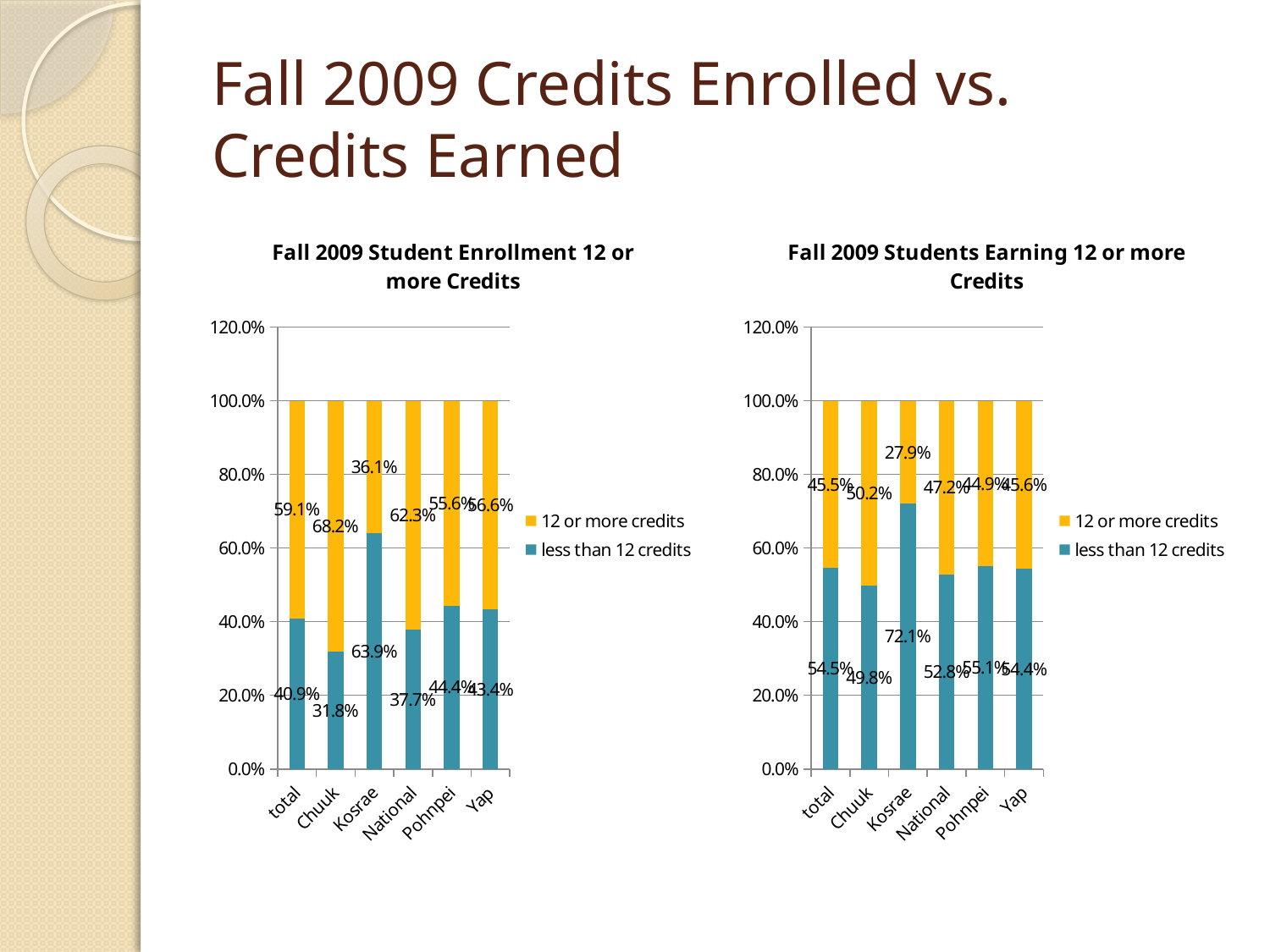
In the 'Fall 2009 Students Earning 12 or more Credits' chart, which category has the lowest '12 or more credits' value? Kosrae In the 'Fall 2009 Students Earning 12 or more Credits' chart, what is the value for Kosrae in the '12 or more credits' series? 27.9% In the 'Fall 2009 Students Earning 12 or more Credits' chart, what is the value for total in the 'less than 12 credits' series? 54.5% In the 'Fall 2009 Student Enrollment 12 or more Credits' chart, what is the difference between the 'less than 12 credits' values for Kosrae and Chuuk? 32.1% In the 'Fall 2009 Student Enrollment 12 or more Credits' chart, what is the value for Kosrae in the 'less than 12 credits' series? 63.9% In the 'Fall 2009 Student Enrollment 12 or more Credits' chart, what is the value for Chuuk in the '12 or more credits' series? 68.2% How many series does the legend of the 'Fall 2009 Student Enrollment 12 or more Credits' chart list? 2 In the 'Fall 2009 Student Enrollment 12 or more Credits' chart, which category has the highest 'less than 12 credits' value? Kosrae In the 'Fall 2009 Students Earning 12 or more Credits' chart, which is larger: the 'less than 12 credits' value for Kosrae or for Chuuk? Kosrae How many categories are shown on the x axis of the 'Fall 2009 Students Earning 12 or more Credits' chart? 6 What kind of chart is the 'Fall 2009 Students Earning 12 or more Credits' chart? Stacked bar chart In the 'Fall 2009 Student Enrollment 12 or more Credits' chart, which category has the lowest 'less than 12 credits' value? Chuuk